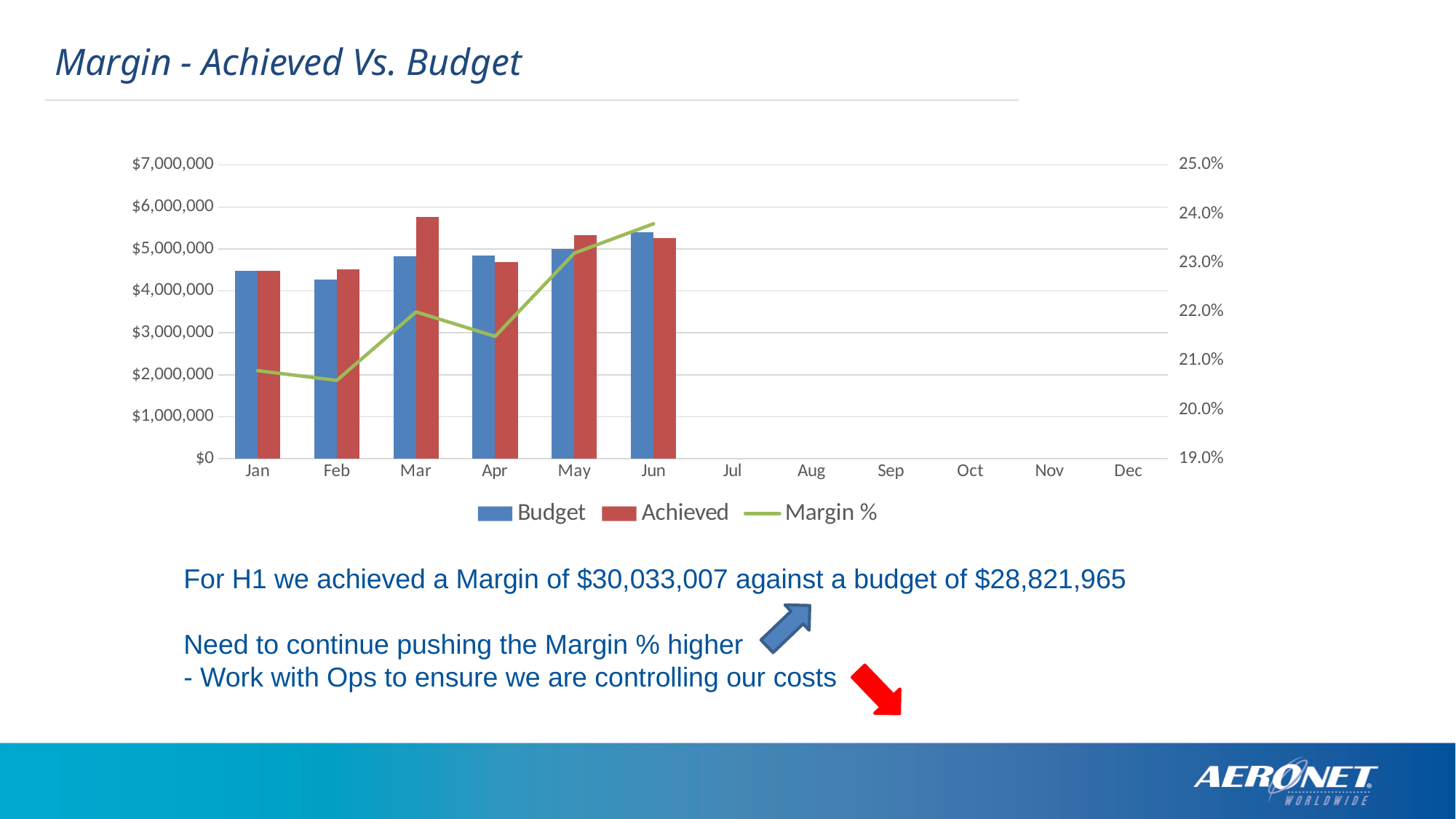
Does the Margin % line rise or fall from Apr to Jun? rise What kind of chart is shown on the slide? bar chart with a line In which month is the Budget bar lowest? Feb In which month is the Achieved bar highest? Mar What is the title of the chart slide? Margin - Achieved Vs. Budget In Mar, which is larger, Budget or Achieved? Achieved How many months on the x axis have bars plotted? 6 Is the Margin % for Jan greater or less than 21.0%? less In Jun, which is larger, Budget or Achieved? Budget How many series does the legend list? 3 Is the Achieved value for Mar greater or less than $5,000,000? greater In which month is the Margin % line highest? Jun